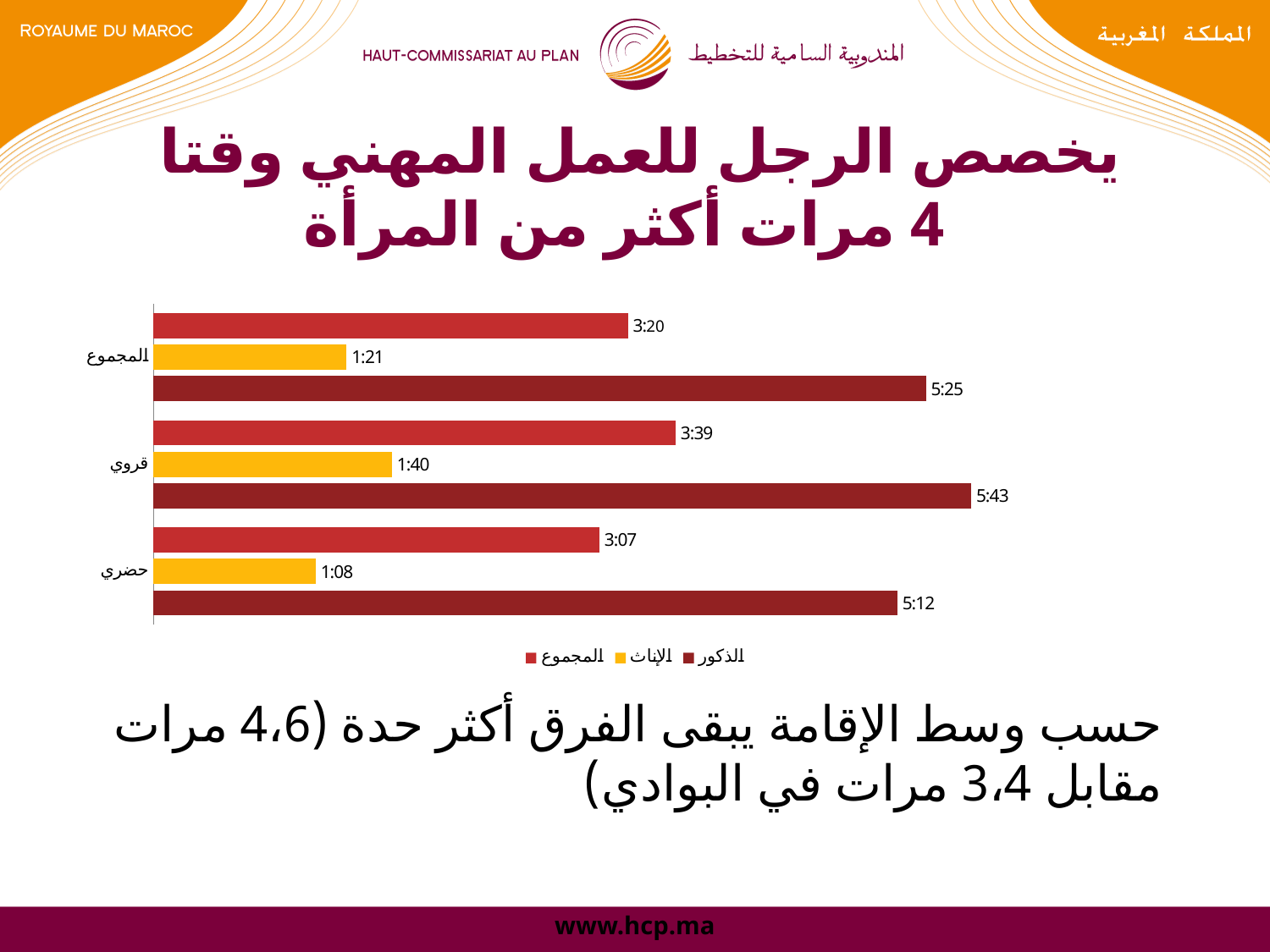
Which series is shown in yellow in the legend? الإناث What is the difference between the الذكور value and the الإناث value in the قروي category? 4:03 How many series does the legend list? 3 What is the value for المجموع (total series) in the المجموع category? 3:20 What is the value for الإناث in the حضري category? 1:08 What is the value for الإناث in the المجموع category? 1:21 Which is larger: the value for الذكور in حضري or the value for الذكور in المجموع? الذكور in المجموع (5:25) Which category has the highest value for الذكور? قروي Which category has the lowest value for الإناث? حضري What is the value for الذكور in the قروي category? 5:43 What kind of chart is shown on the slide? Bar chart How many categories are shown on the chart? 3